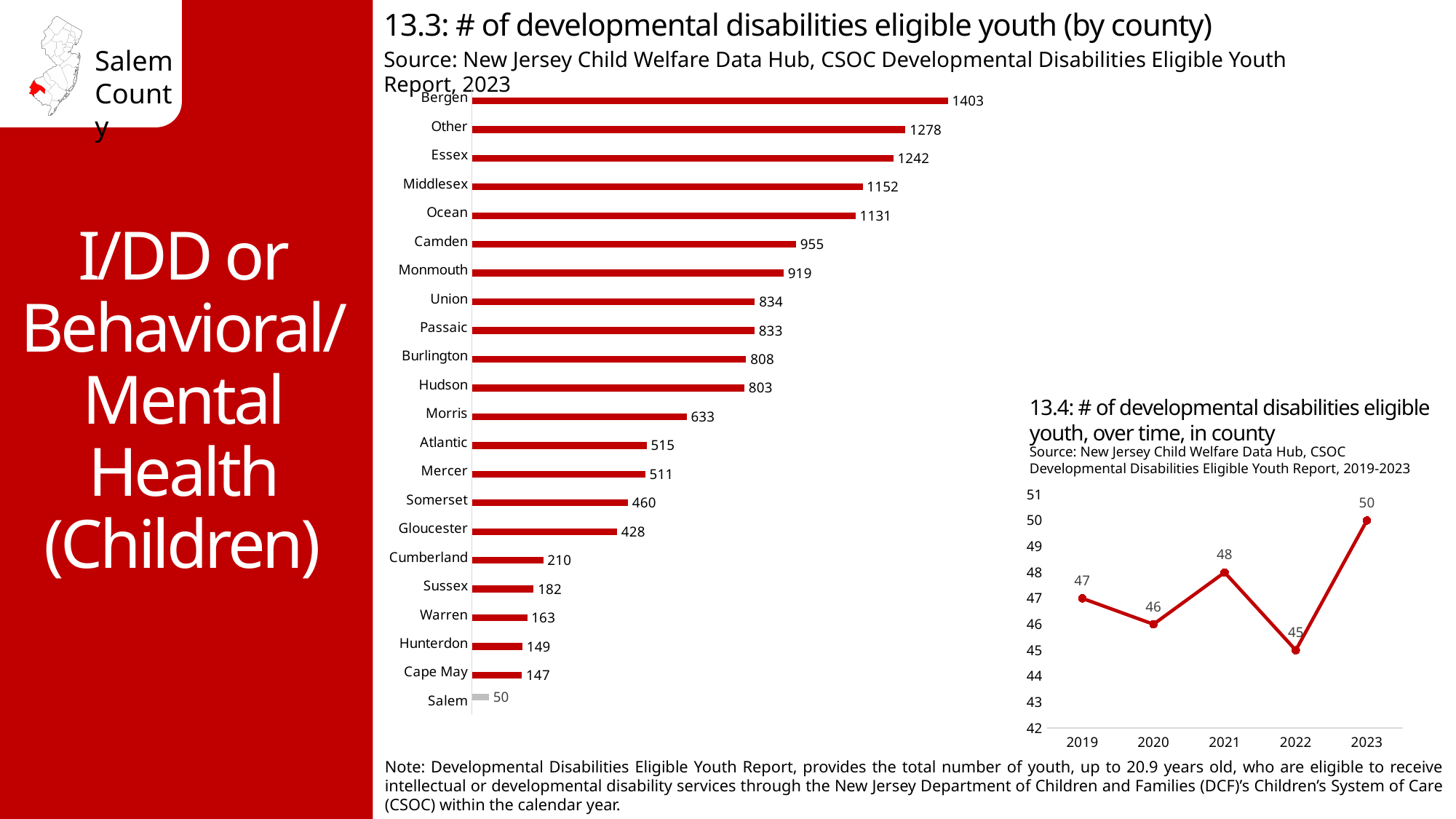
In chart 13.3 (# of developmental disabilities eligible youth by county), what is the value for Bergen? 1403 In chart 13.3 (# of developmental disabilities eligible youth by county), what is the value for Salem? 50 In chart 13.3 (# of developmental disabilities eligible youth by county), what is the difference between Camden and Monmouth? 36 In chart 13.3 (# of developmental disabilities eligible youth by county), which is larger, Morris or Atlantic? Morris In chart 13.3 (# of developmental disabilities eligible youth by county), which category has the highest value? Bergen In chart 13.4 (# of developmental disabilities eligible youth over time in county), what is the difference between 2023 and 2022? 5 In chart 13.4 (# of developmental disabilities eligible youth over time in county), which year has the lowest value? 2022 In chart 13.3 (# of developmental disabilities eligible youth by county), which county has the lowest value? Salem In chart 13.4 (# of developmental disabilities eligible youth over time in county), what is the value for 2021? 48 What kind of chart is chart 13.4 (# of developmental disabilities eligible youth over time in county)? Line chart What kind of chart is chart 13.3 (# of developmental disabilities eligible youth by county)? Bar chart In chart 13.3 (# of developmental disabilities eligible youth by county), how many categories are shown? 22